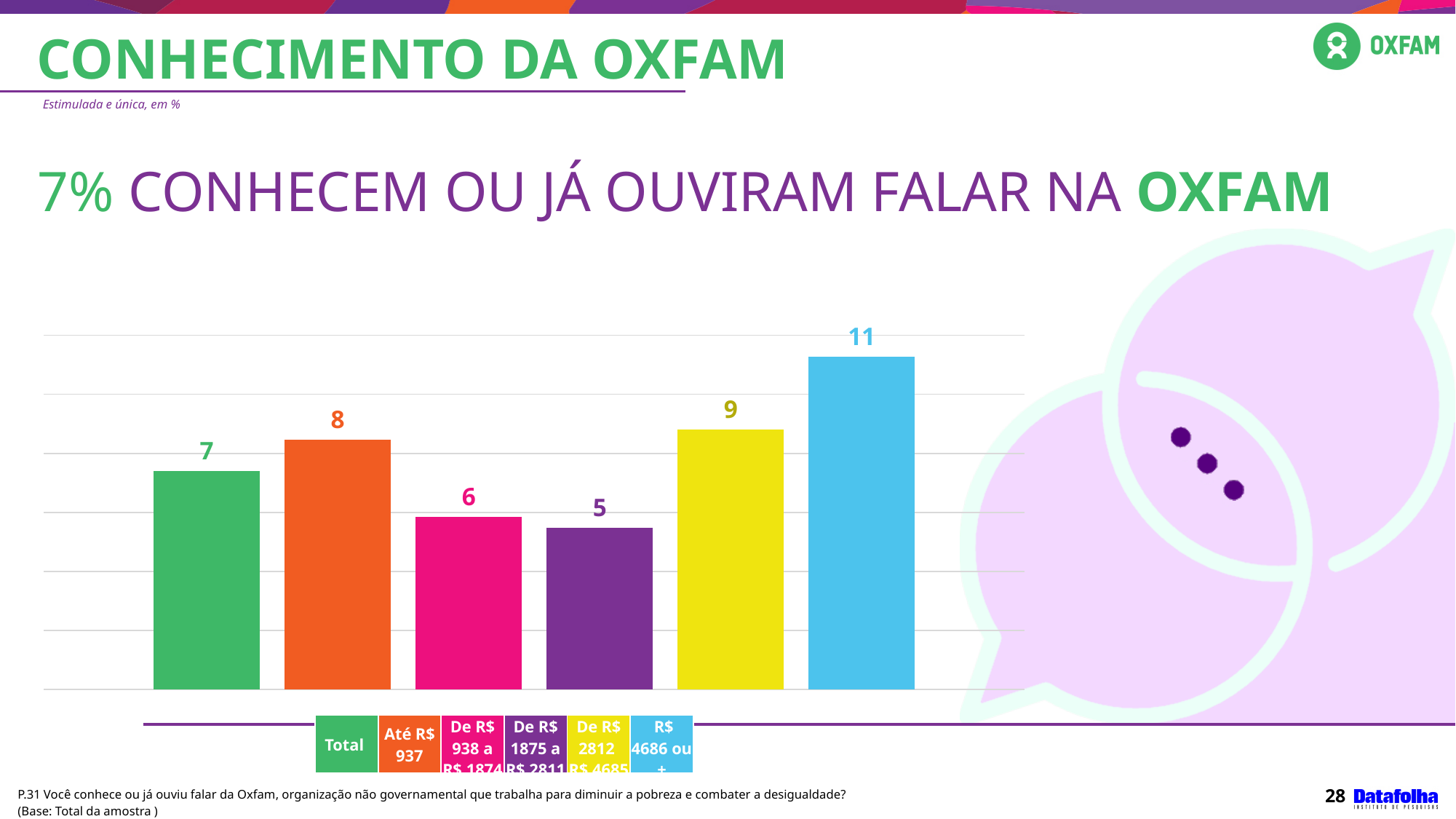
Which income group has the highest value? R$ 4686 ou + What is the value for the 'Até R$ 937' income group? 8 What is the value for the Total bar? 7 What is the value for the 'De R$ 1875 a R$ 2811' income group? 5 What kind of chart is shown on the slide? Bar chart How many bars are shown in the chart? 6 What is the value for the 'R$ 4686 ou +' income group? 11 What is the difference between the 'R$ 4686 ou +' value and the 'De R$ 1875 a R$ 2811' value? 6 Which is larger, the value for 'Até R$ 937' or the value for 'De R$ 938 a R$ 1874'? Até R$ 937 What is the difference between the 'De R$ 2812 a R$ 4685' value and the Total value? 2 Which income group has the lowest value? De R$ 1875 a R$ 2811 What colour is the bar for 'De R$ 2812 a R$ 4685'? Yellow